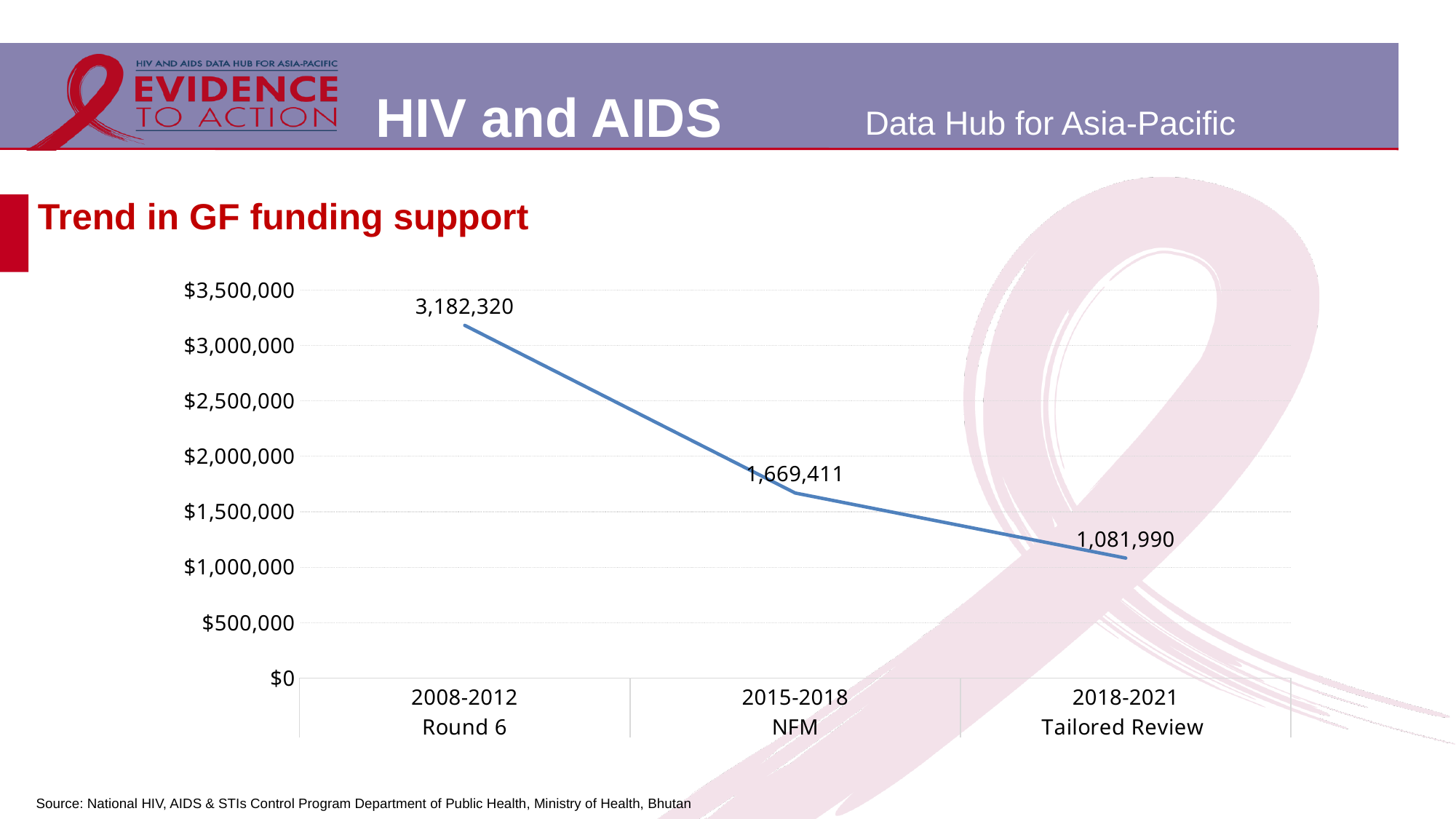
What is the difference in funding between 2015-2018 NFM and 2018-2021 Tailored Review? 587,421 What kind of chart is shown on the slide? line chart Is the value for 2018-2021 Tailored Review greater or less than $1,500,000? less What is the GF funding value for 2008-2012 Round 6? 3,182,320 Do the values rise or fall across the periods from left to right? fall What is the GF funding value for 2015-2018 NFM? 1,669,411 Which is larger, the funding for 2015-2018 NFM or for 2018-2021 Tailored Review? 2015-2018 NFM Which period has the highest GF funding support? 2008-2012 Round 6 How many periods are plotted on the chart? 3 What is the GF funding value for 2018-2021 Tailored Review? 1,081,990 What is the difference in funding between 2008-2012 Round 6 and 2015-2018 NFM? 1,512,909 Which period has the lowest GF funding support? 2018-2021 Tailored Review